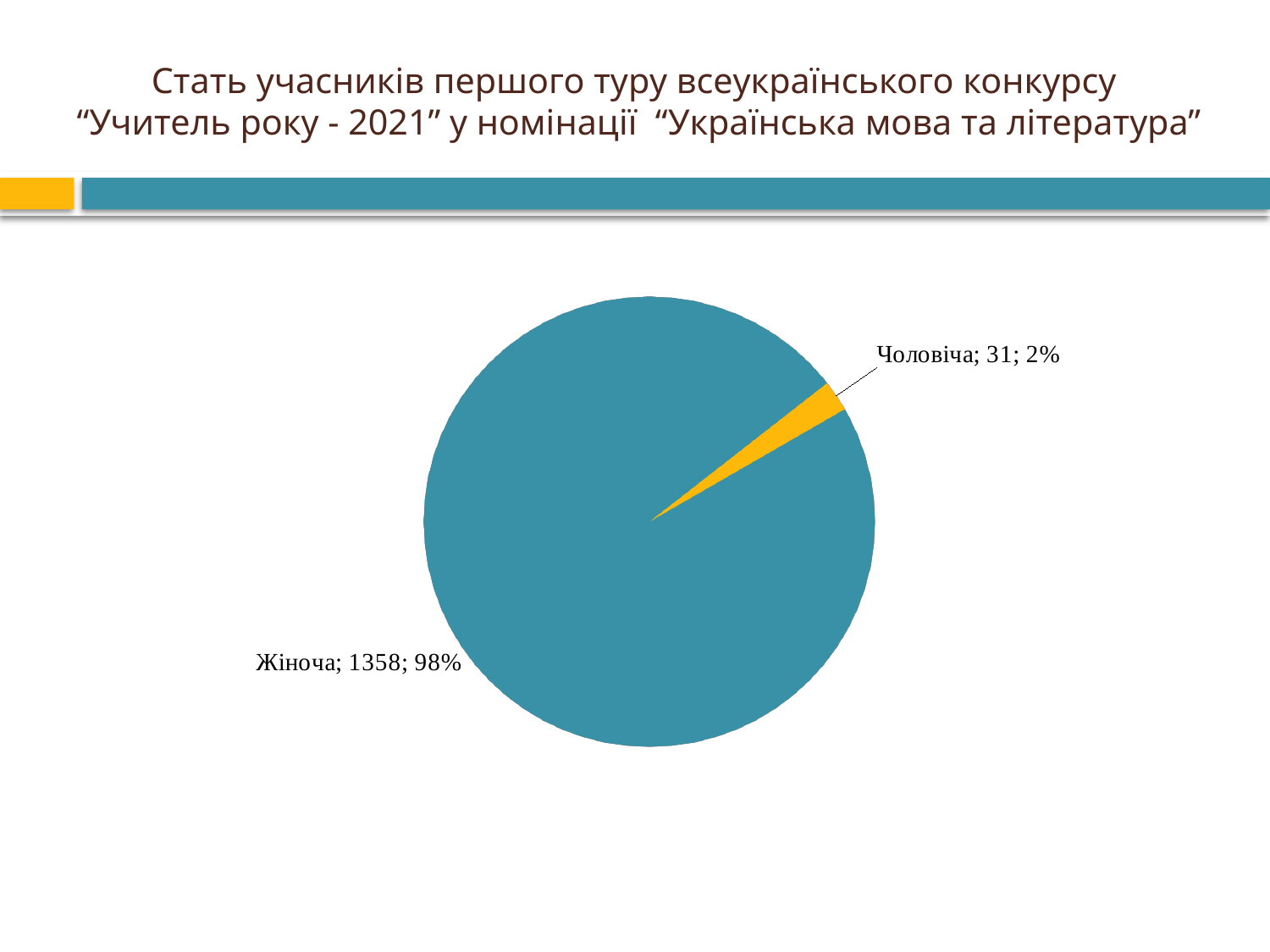
What is the value for Чоловіча? 31 Which category has the smallest slice? Чоловіча How many slices does the pie chart have? 2 What share of the pie does Жіноча represent? 98% Which is larger, the value for Жіноча or the value for Чоловіча? Жіноча What share of the pie does Чоловіча represent? 2% Which category has the largest slice? Жіноча What is the total of the two slices in the pie chart? 1389 What is the value for Жіноча? 1358 What kind of chart is shown on the slide? pie chart What is the difference between the values for Жіноча and Чоловіча? 1327 What colour is the Чоловіча slice? yellow